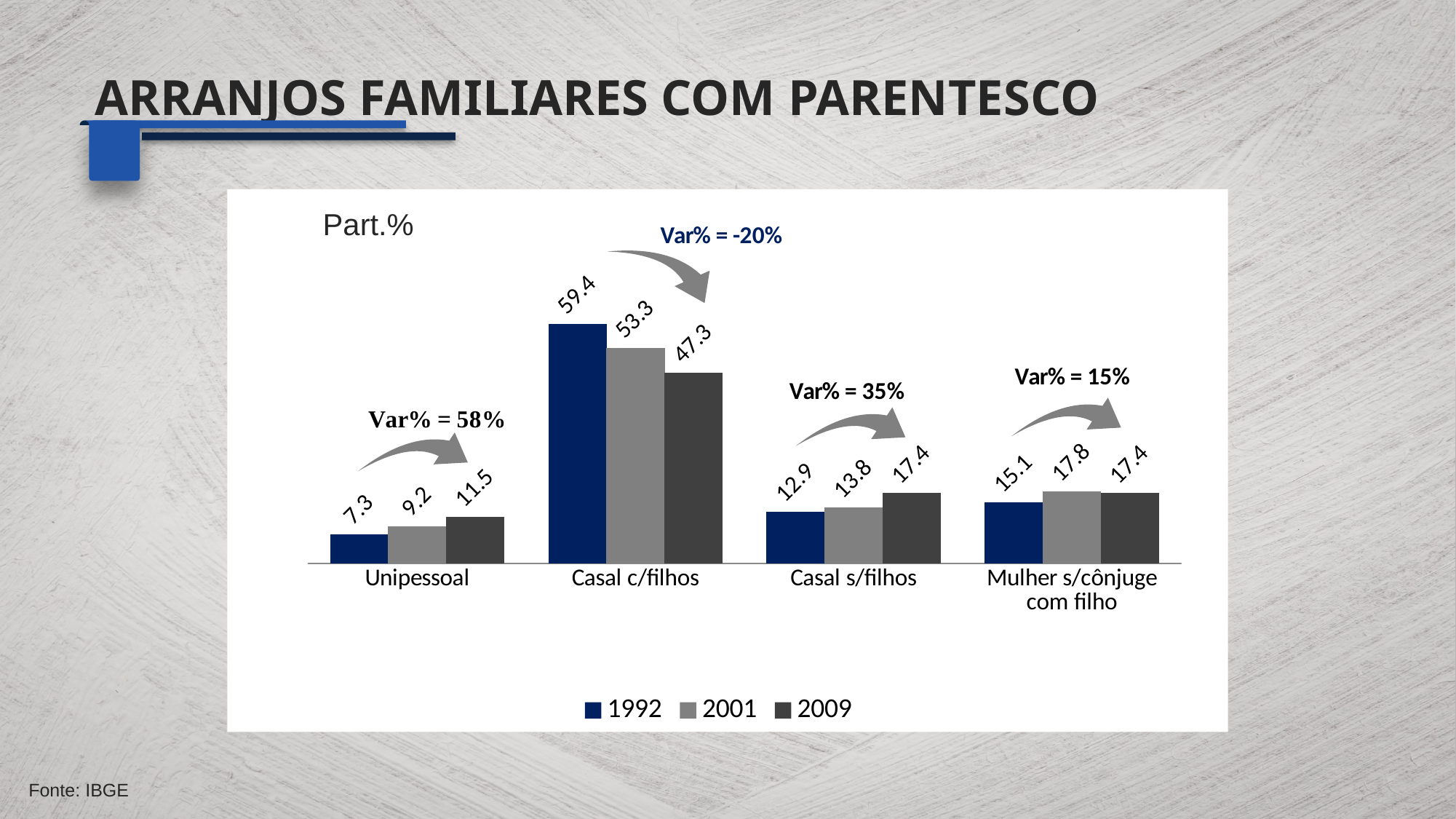
How many categories are shown on the x axis? 4 Which category has the highest value in 2009? Casal c/filhos What Var% is annotated above the Casal s/filhos bars? Var% = 35% How many series does the legend list? 3 What is the value for Unipessoal in 2009? 11.5 What is the value for Mulher s/cônjuge com filho in 2001? 17.8 What kind of chart is shown on the slide? Bar chart What is the difference between the 1992 and 2009 values for Casal c/filhos? 12.1 Which category has the lowest value in 1992? Unipessoal Which is larger: the 2009 value for Casal s/filhos or the 2009 value for Unipessoal? Casal s/filhos Do the values for Casal c/filhos rise or fall from 1992 to 2009? Fall What is the value for Casal c/filhos in 1992? 59.4